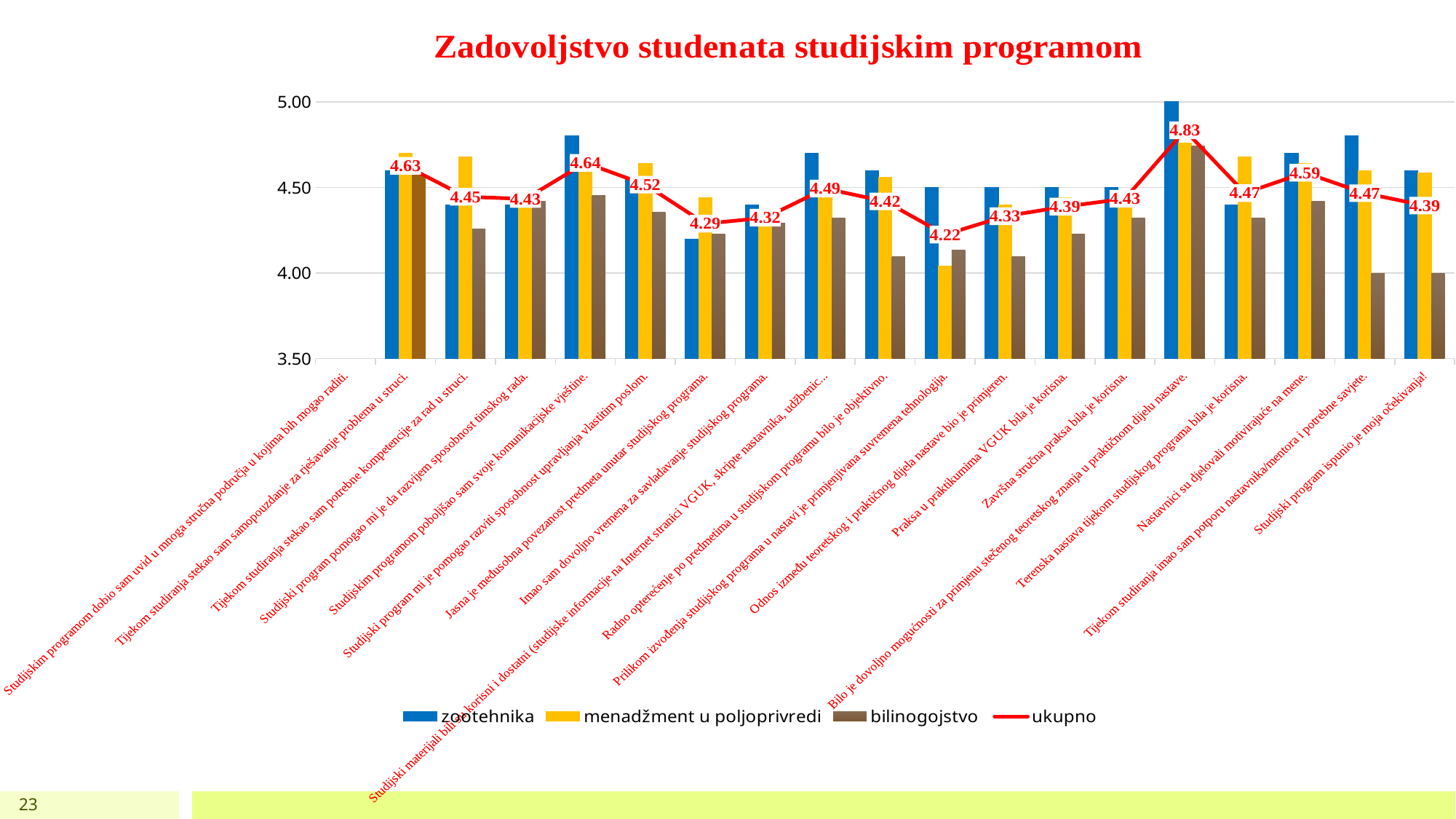
What is the title of the chart? Zadovoljstvo studenata studijskim programom What kind of chart is shown on the slide? bar chart with a line Is the 'menadžment u poljoprivredi' value for 'Prilikom izvođenja studijskog programa u nastavi je primjenjivana suvremena tehnologija.' greater or less than 4.50? less Which has the higher 'ukupno' value: 'Praksa u praktikumima VGUK bila je korisna.' or 'Terenska nastava tijekom studijskog programa bila je korisna.'? Terenska nastava tijekom studijskog programa bila je korisna. What is the difference between the highest and lowest 'ukupno' values labelled on the line? 0.61 How many series does the legend list? 4 What is the highest value labelled on the 'ukupno' line? 4.83 What is the 'ukupno' value for 'Nastavnici su djelovali motivirajuće na mene.'? 4.59 Is the 'zootehnika' value for 'Bilo je dovoljno mogućnosti za primjenu stečenog teoretskog znanja u praktičnom dijelu nastave.' greater or less than 4.50? greater What is the lowest value labelled on the 'ukupno' line? 4.22 What is the 'ukupno' value for 'Studijskim programom poboljšao sam svoje komunikacijske vještine.'? 4.64 What is the 'ukupno' value for 'Završna stručna praksa bila je korisna.'? 4.43